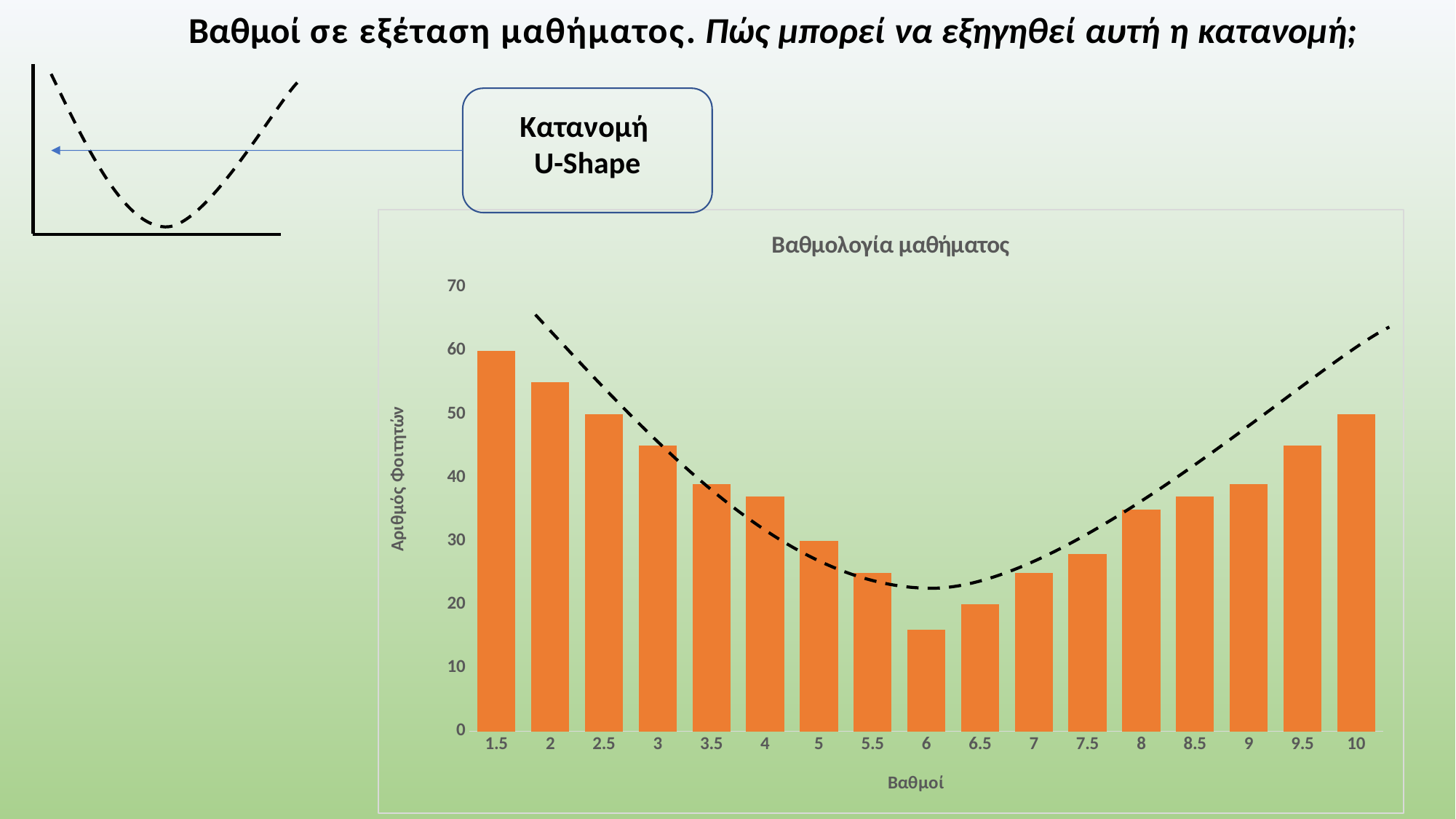
Is the number of students for grade 6 greater or less than 20? less What is the number of students for grade 1.5? 60 What is the title of the chart? Βαθμολογία μαθήματος Which grade category has the lowest number of students? 6 What kind of chart is shown on the slide? bar chart Is the number of students for grade 10 greater or less than 40? greater How do the bar values change from left to right along the x axis? They fall to a minimum at 6, then rise How many grade categories are shown on the x axis of the chart? 17 Which has more students, grade 2 or grade 9? grade 2 What is the label of the vertical axis of the chart? Αριθμός Φοιτητών Is the number of students for grade 7 greater or less than 30? less Which grade category has the highest number of students? 1.5